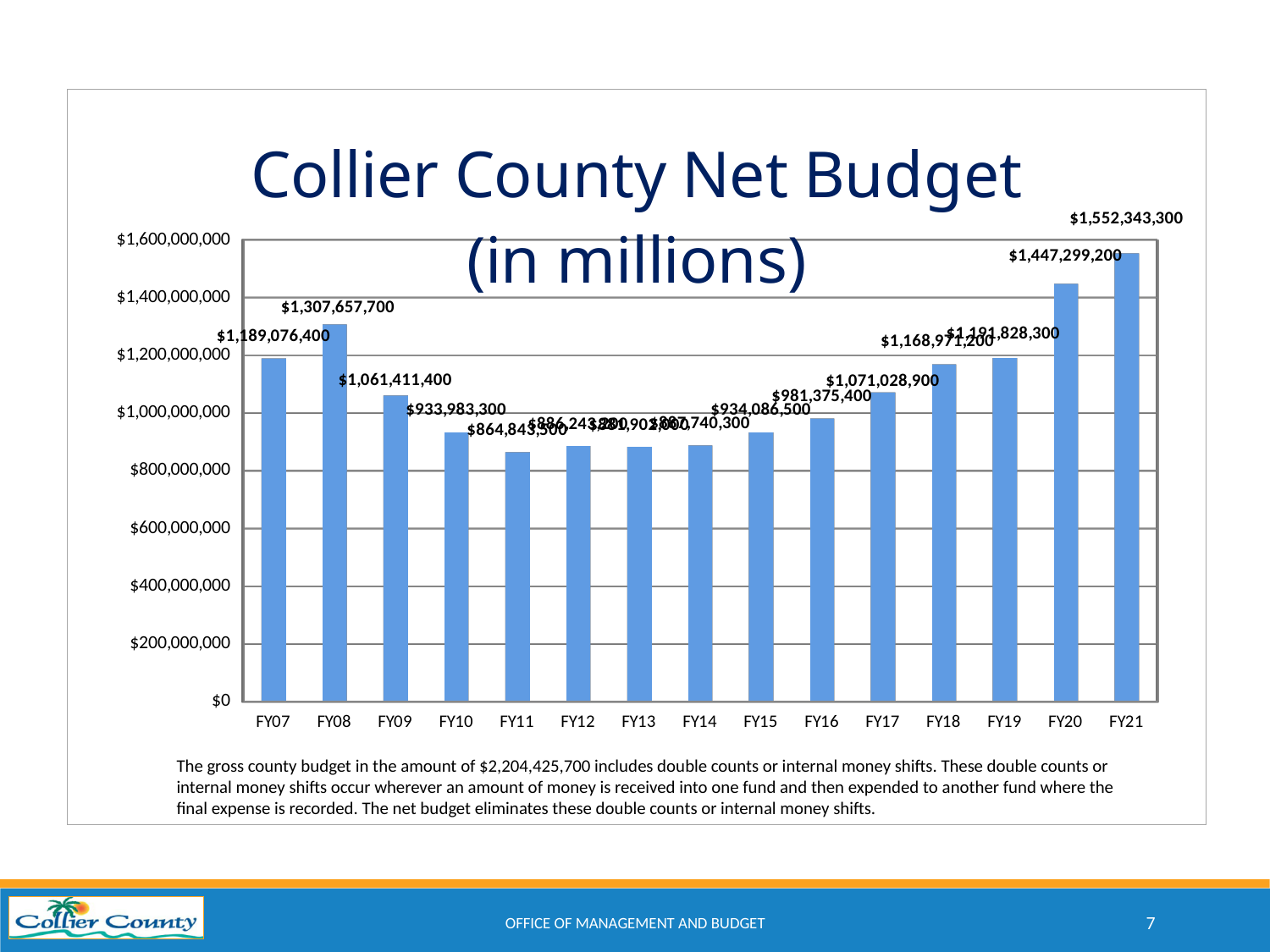
How many fiscal years are plotted on the chart? 15 What kind of chart is shown on the slide? bar chart What is the net budget for FY07? $1,189,076,400 Which is larger, the net budget for FY08 or for FY09? FY08 Is the value for FY13 greater or less than $1,000,000,000? less What is the net budget for FY21? $1,552,343,300 What is the difference between the FY21 and FY20 net budgets? $105,044,100 What is the net budget for FY16? $981,375,400 What is the difference between the FY08 and FY07 net budgets? $118,581,300 Which fiscal year has the highest net budget? FY21 Do the net budget values rise or fall from FY17 to FY21? rise What is the net budget for FY08? $1,307,657,700